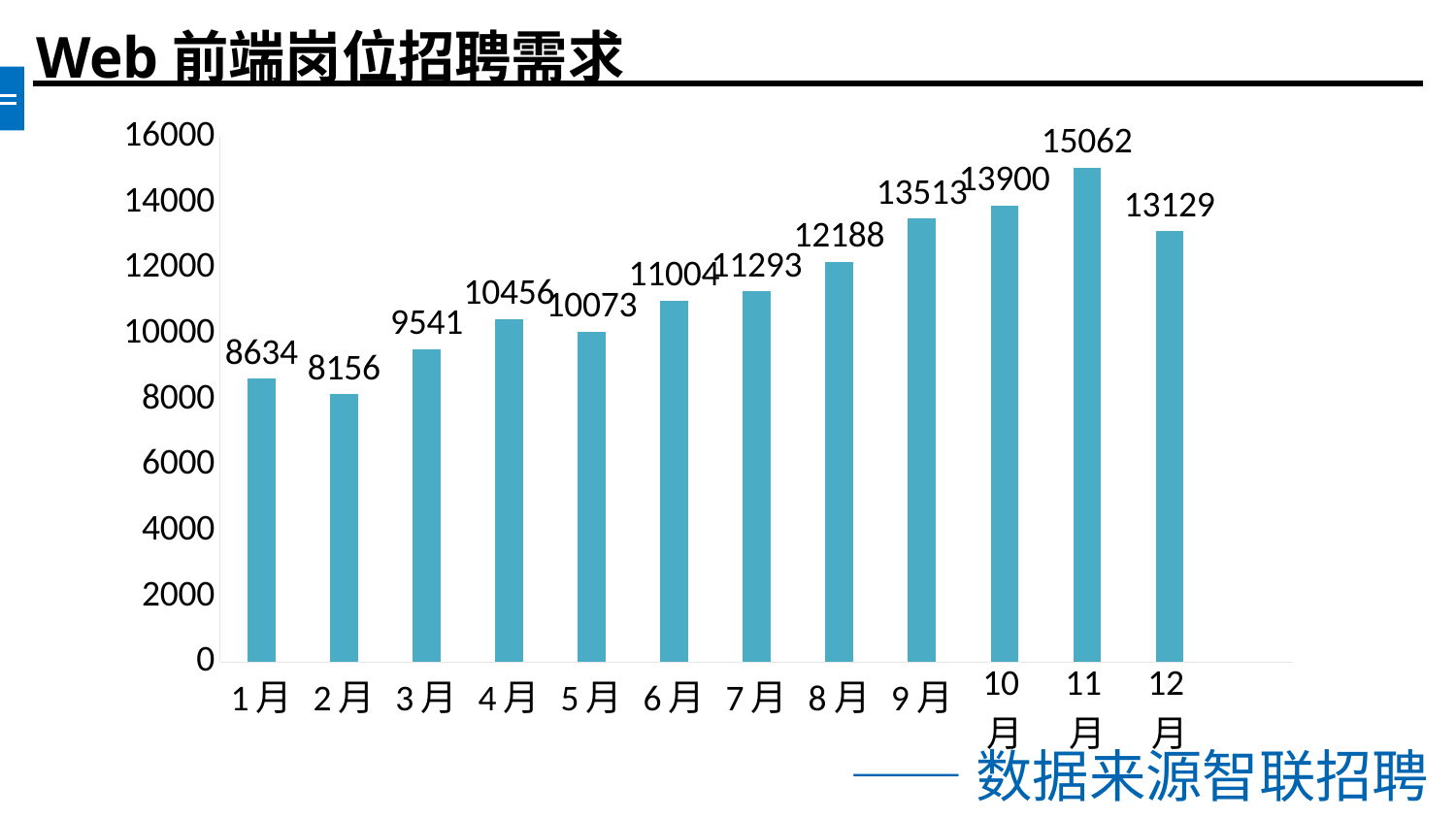
Which is larger, the value for 4月 or the value for 5月? 4月 What is the value for 11月? 15062 Which month has the lowest value? 2月 What is the difference between the values for 11月 and 12月? 1933 How many months are shown on the x axis? 12 What kind of chart is shown on the slide? bar chart What is the value for 1月? 8634 What is the value for 5月? 10073 Which month has the highest value? 11月 What is the difference between the values for 1月 and 2月? 478 What is the title of the slide? Web 前端岗位招聘需求 Is the value for 9月 greater or less than 12000? greater